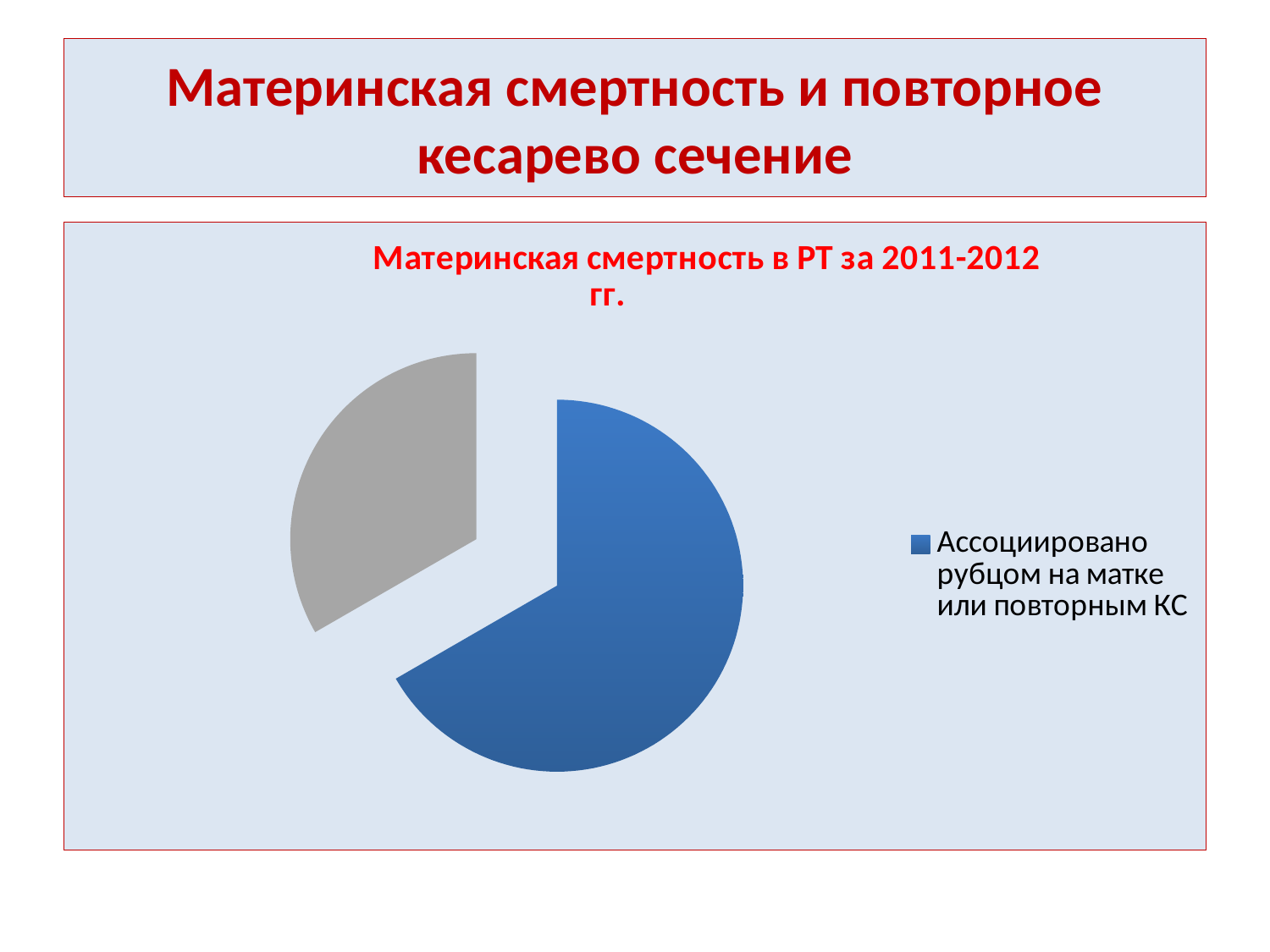
How many entries does the chart legend list? 1 Which is larger: the blue slice or the gray slice? the blue slice What is the title of the chart? Материнская смертность в РТ за 2011-2012 гг. Which slice of the pie is the smallest? the gray slice Does the slice labelled 'Ассоциировано рубцом на матке или повторным КС' take up more or less than half of the pie? more What is the legend entry shown for the chart? Ассоциировано рубцом на матке или повторным КС Which slice of the pie is the largest? the blue slice (Ассоциировано рубцом на матке или повторным КС) What kind of chart is shown on the slide? pie chart How many slices does the pie chart have? 2